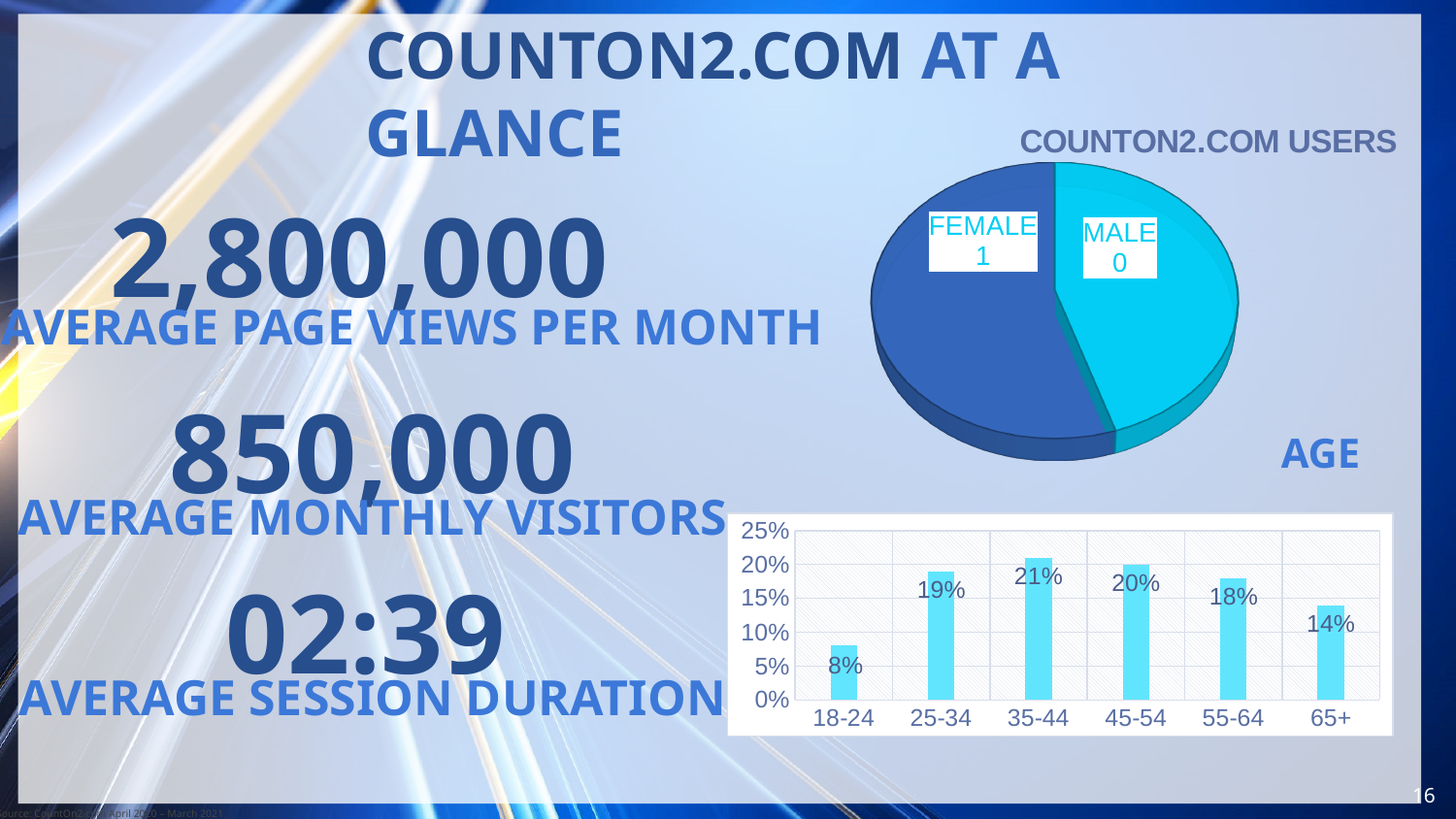
In the COUNTON2.COM USERS pie chart, which slice is larger, FEMALE or MALE? FEMALE In the AGE bar chart, what is the value for the 65+ age group? 14% In the AGE bar chart, what is the value for the 18-24 age group? 8% How many age groups are shown in the AGE bar chart? 6 In the AGE bar chart, do the values rise or fall from 35-44 to 65+? fall What kind of chart is the AGE chart? bar chart In the AGE bar chart, what is the difference between the values for 35-44 and 18-24? 13% In the AGE bar chart, is the value for 45-54 greater or less than 15%? greater In the AGE bar chart, which age group has the highest value? 35-44 In the AGE bar chart, what is the value for the 35-44 age group? 21% In the AGE bar chart, which is larger, the value for 25-34 or the value for 55-64? 25-34 In the AGE bar chart, which age group has the lowest value? 18-24